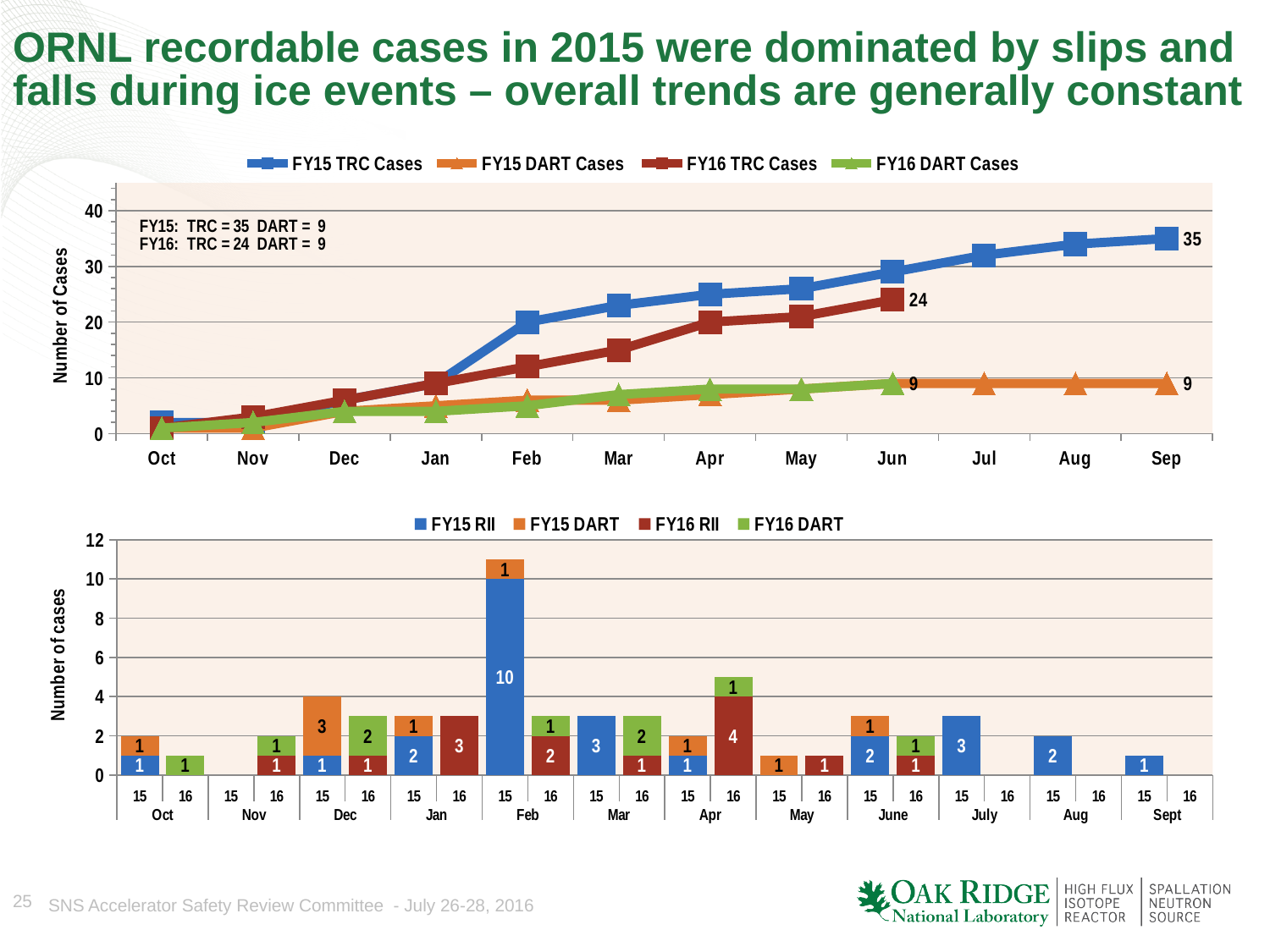
In the bottom bar chart, what is the FY15 RII value for Feb? 10 In the top line chart, do the FY15 TRC Cases values rise or fall from Oct to Sep? rise In the top line chart, how many months are shown on the x axis? 12 In the bottom bar chart, what is the total of the stacked bar for Apr 16? 5 What kind of chart is the bottom chart on the slide? bar chart In the top line chart, how many series does the legend list? 4 In the top line chart, what is the value of FY15 TRC Cases at Sep? 35 In the bottom bar chart, what is the total of the stacked bar for Feb 15? 11 In the bottom bar chart, which month has the tallest stacked bar? Feb In the top line chart, what is the value of FY16 TRC Cases at Jun? 24 In the top line chart, what is the difference between the FY15 TRC Cases value at Sep and the FY16 TRC Cases value at Jun? 11 In the top line chart, is the value of FY15 TRC Cases at Feb greater or less than 10? greater